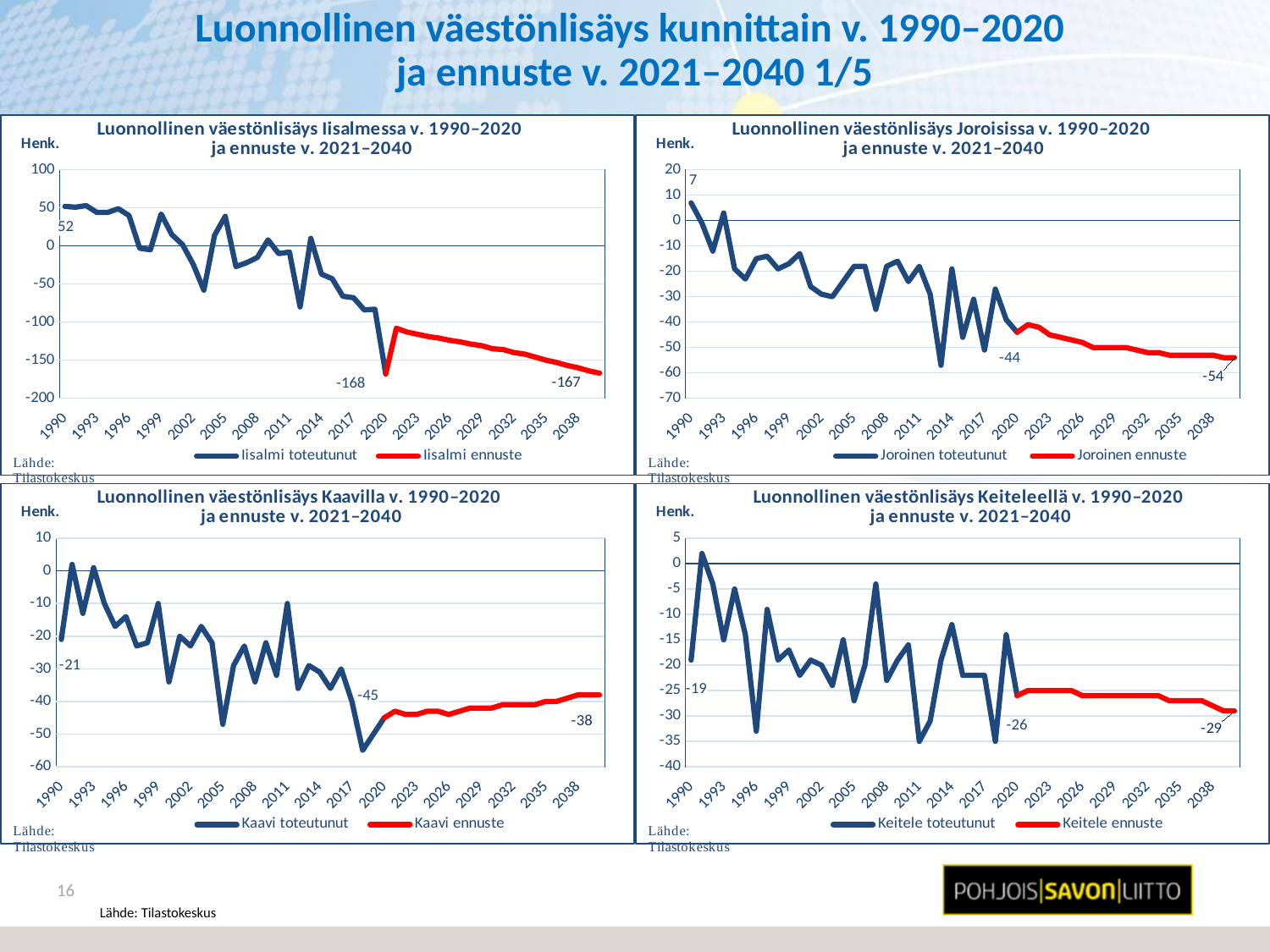
How many series does the legend of the Keitele chart (bottom right) list? 2 In the Iisalmi chart (top left), what is the data label shown for 1990? 52 In the Kaavi chart (bottom left), does the red forecast line rise or fall from 2021 to 2040? rise What type of chart is used for the Joroinen chart (top right)? line chart In the Joroinen chart (top right), what is the forecast value labelled for 2040? -54 In the Kaavi chart (bottom left), which labelled value is larger: 1990 or 2020? 1990 In the Joroinen chart (top right), is the value for 2014 greater or less than -50? greater In the Keitele chart (bottom right), what is the data label shown for 1990? -19 In the Kaavi chart (bottom left), what value is labelled for 2020? -45 In the Iisalmi chart (top left), what value is labelled for 2020? -168 In the Keitele chart (bottom right), by how much does the labelled 2040 value (-29) differ from the labelled 1990 value (-19)? 10 In the Iisalmi chart (top left), what is the difference between the 1990 value (52) and the 2020 value (-168)? 220